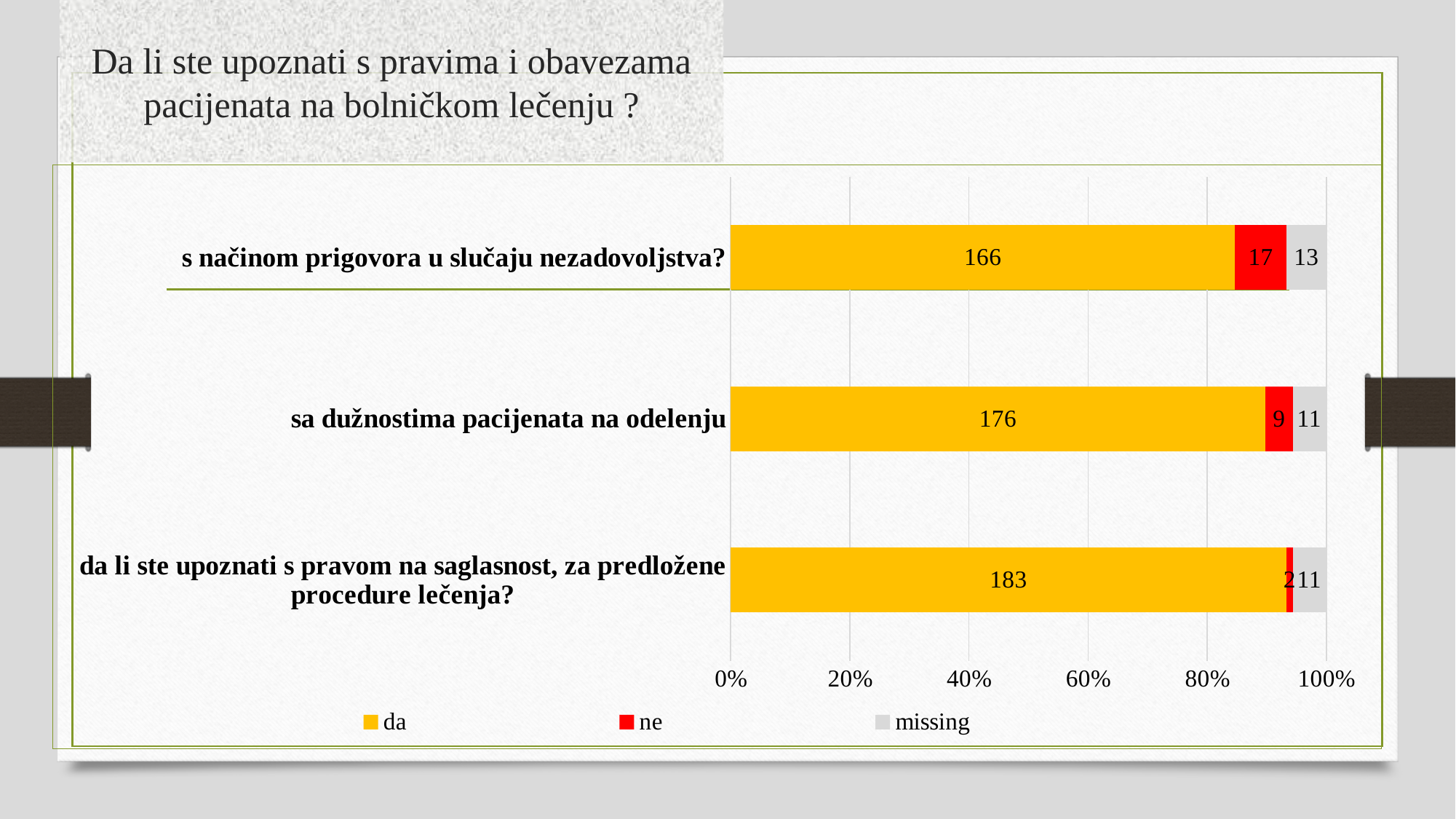
What is the total of the stacked bar for 'sa dužnostima pacijenata na odelenju'? 196 What is the 'da' value for 'da li ste upoznati s pravom na saglasnost, za predložene procedure lečenja?'? 183 How many categories are plotted in the chart? 3 What kind of chart is shown on the slide? bar chart What is the 'missing' value for 's načinom prigovora u slučaju nezadovoljstva?'? 13 Which category has the highest 'ne' value? s načinom prigovora u slučaju nezadovoljstva? How many series does the legend list? 3 Which category has the highest 'da' value? da li ste upoznati s pravom na saglasnost, za predložene procedure lečenja? What is the difference between the 'da' values for 'sa dužnostima pacijenata na odelenju' and 's načinom prigovora u slučaju nezadovoljstva?'? 10 Which series is shown in red in the legend? ne What is the 'ne' value for 'sa dužnostima pacijenata na odelenju'? 9 What is the 'da' value for 's načinom prigovora u slučaju nezadovoljstva?'? 166